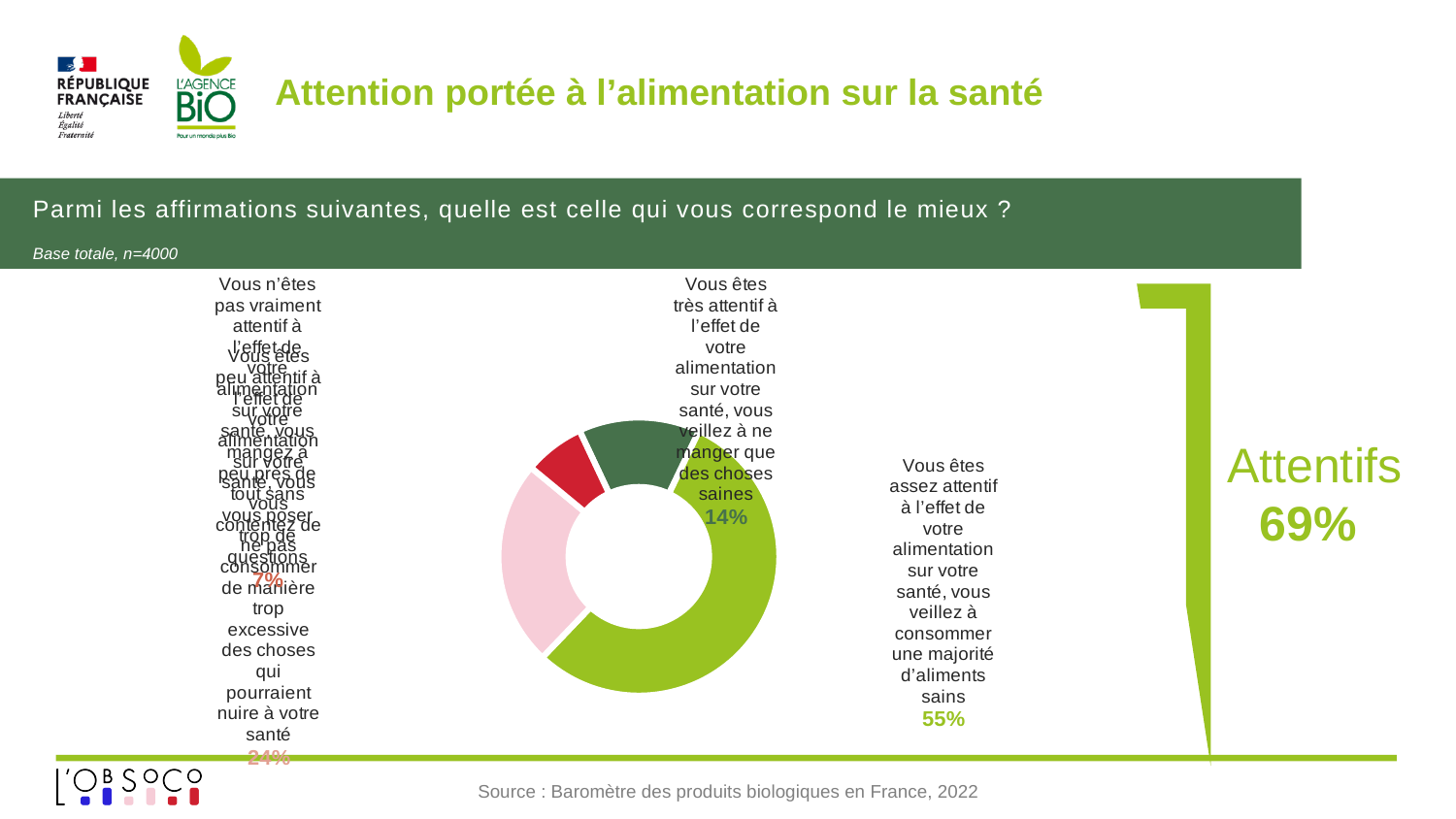
Which share is larger: 'assez attentif' or 'très attentif'? Assez attentif What is the smallest percentage shown on the donut chart? 7% What is the total base (n) for the survey question shown? n=4000 What is the source cited for the chart? Baromètre des produits biologiques en France, 2022 What percentage of respondents say they are 'assez attentif' (fairly attentive) to the effect of their diet on their health? 55% What type of chart is used on this slide? Pie (donut) chart What percentage of respondents say they are 'très attentif' (very attentive) to the effect of their diet on their health? 14% Which statement has the largest share in the donut chart? Vous êtes assez attentif à l'effet de votre alimentation sur votre santé (55%) What is the value of the red slice in the donut chart? 7% What combined percentage is shown for 'Attentifs' on the right of the slide? 69% How many slices does the donut chart have? 4 What is the difference in percentage points between the 'assez attentif' share and the 'très attentif' share? 41 percentage points